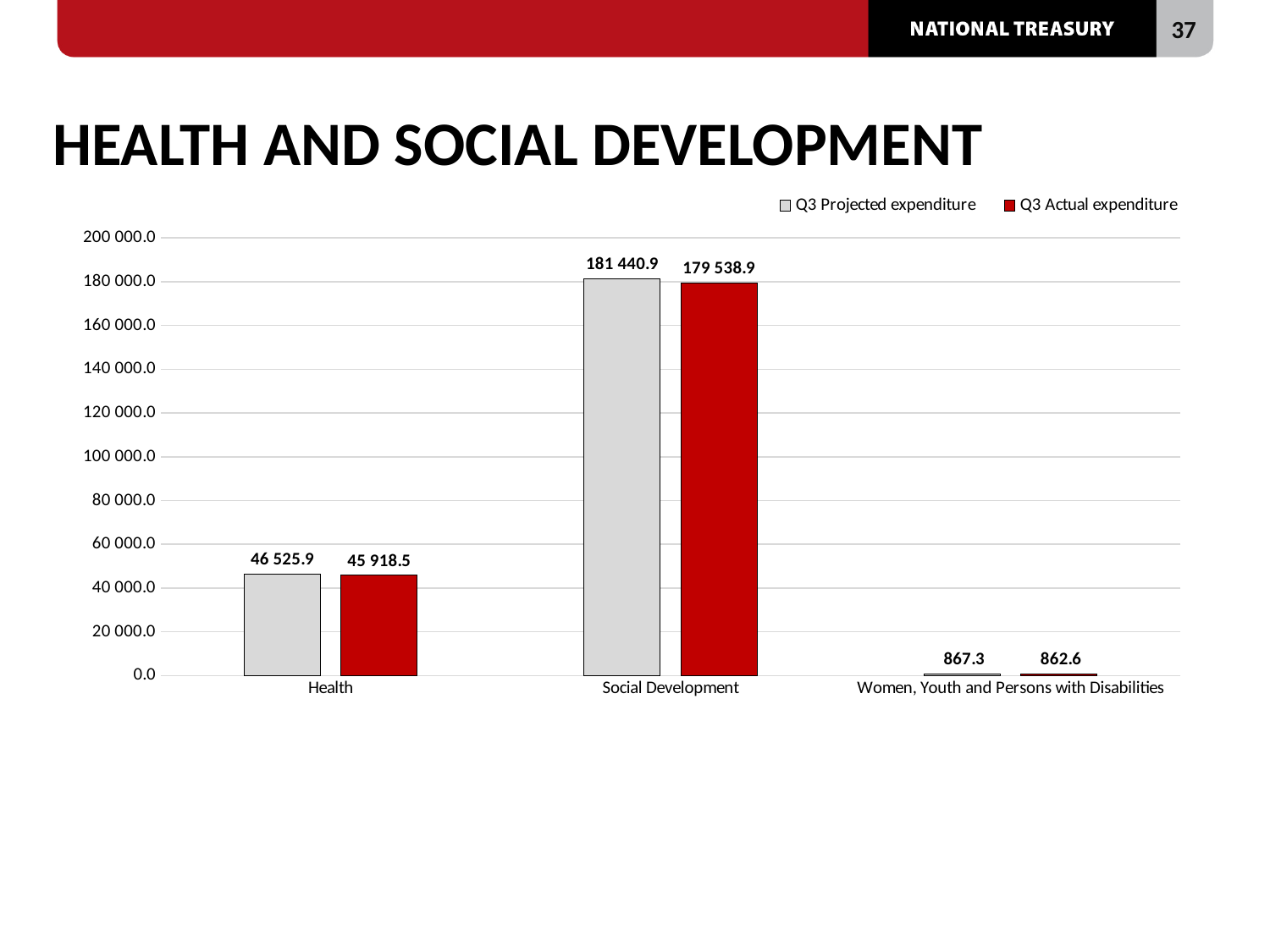
Is the Q3 Actual expenditure for Health greater or less than 40 000.0? greater What is the Q3 Projected expenditure for Health? 46 525.9 Which is larger for Health: the Q3 Projected expenditure or the Q3 Actual expenditure? Q3 Projected expenditure How many categories are shown on the x axis of the chart? 3 What is the Q3 Actual expenditure for Social Development? 179 538.9 How many series does the legend list? 2 What kind of chart is shown on the slide? Bar chart What is the difference between the Q3 Projected and Q3 Actual expenditure for Health? 607.4 What is the Q3 Actual expenditure for Women, Youth and Persons with Disabilities? 862.6 Which category has the highest Q3 Projected expenditure? Social Development What is the difference between the Q3 Projected and Q3 Actual expenditure for Social Development? 1 902.0 Which category has the lowest Q3 Actual expenditure? Women, Youth and Persons with Disabilities